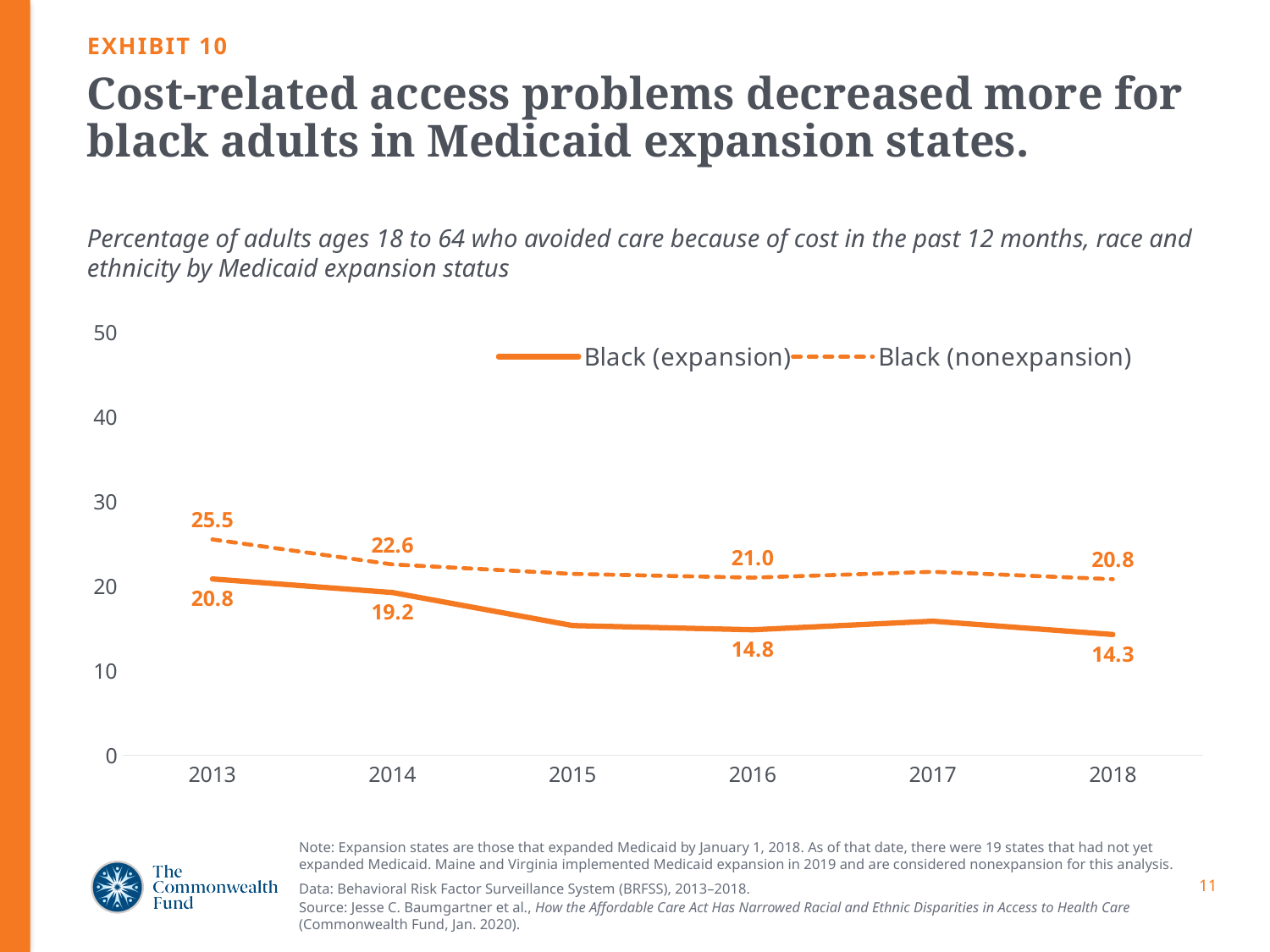
What is the value for Black (expansion) in 2013? 20.8 How many years are shown on the x axis? 6 What kind of chart is shown on the slide? line chart How many series does the legend list? 2 What is the value for Black (expansion) in 2018? 14.3 Does the Black (nonexpansion) line generally rise or fall from 2013 to 2018? fall What is the difference between the Black (nonexpansion) and Black (expansion) values in 2018? 6.5 What is the value for Black (nonexpansion) in 2013? 25.5 By how much did the Black (expansion) value fall from 2013 to 2018? 6.5 Which series has the higher value in 2014, Black (expansion) or Black (nonexpansion)? Black (nonexpansion) What is the value for Black (nonexpansion) in 2016? 21.0 Is the value for Black (expansion) in 2015 greater or less than 20? less